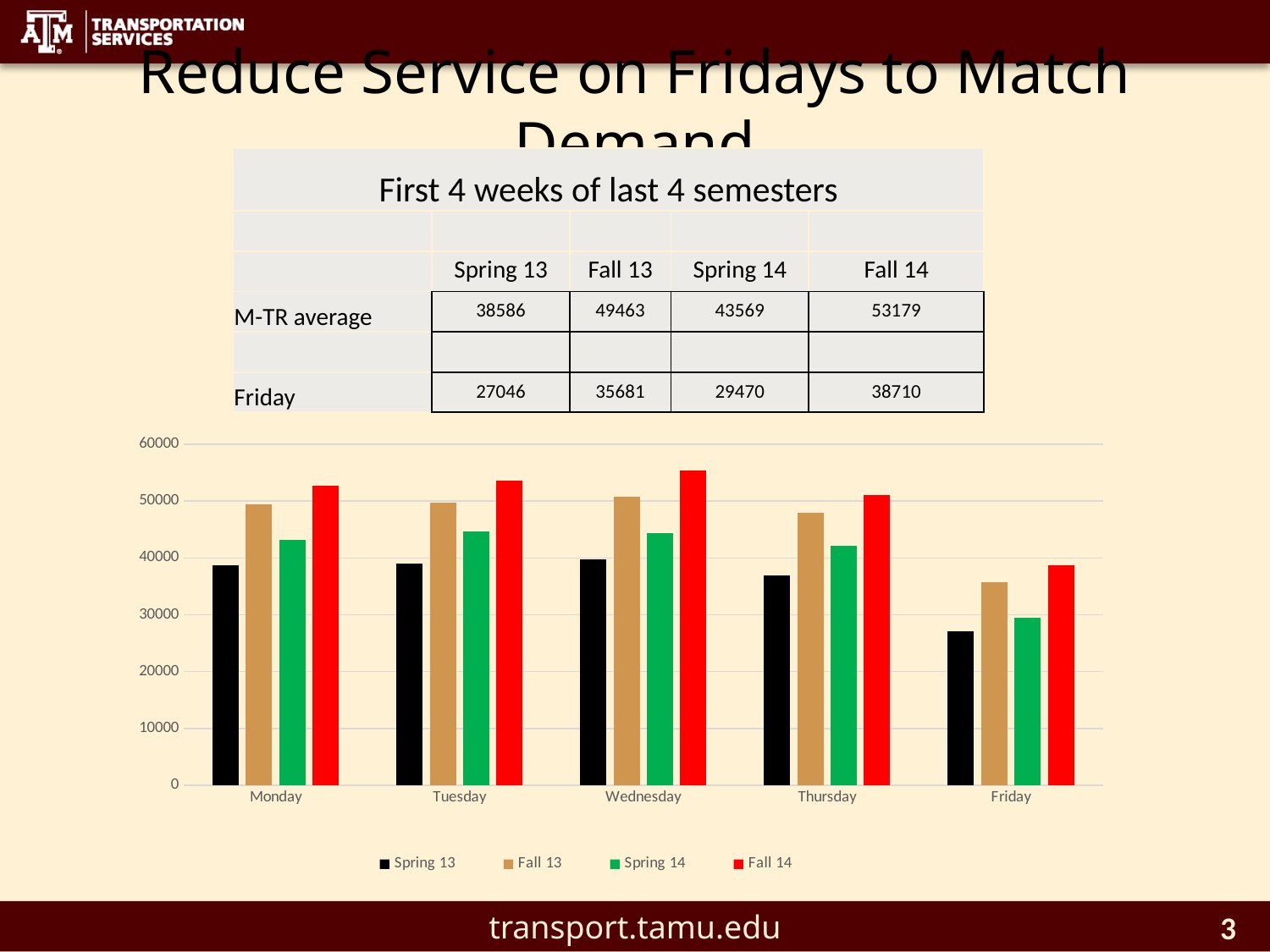
Which day has the lowest Spring 13 bar in the chart? Friday Is the Fall 14 value for Wednesday greater or less than 50000? greater How many series does the chart legend list? 4 Which day has the tallest Fall 14 bar in the chart? Wednesday On Thursday, which is larger: the Fall 14 bar or the Fall 13 bar? Fall 14 On Monday, which is larger: the Fall 13 bar or the Spring 14 bar? Fall 13 What colour represents Fall 14 in the chart legend? red Which series has the tallest bar on every day of the week in the chart? Fall 14 How many days (categories) are shown along the x axis of the chart? 5 Is the Spring 13 value for Friday greater or less than 30000? less What kind of chart is shown on the slide? bar chart According to the table above the chart, what is the Friday value for Fall 14? 38710